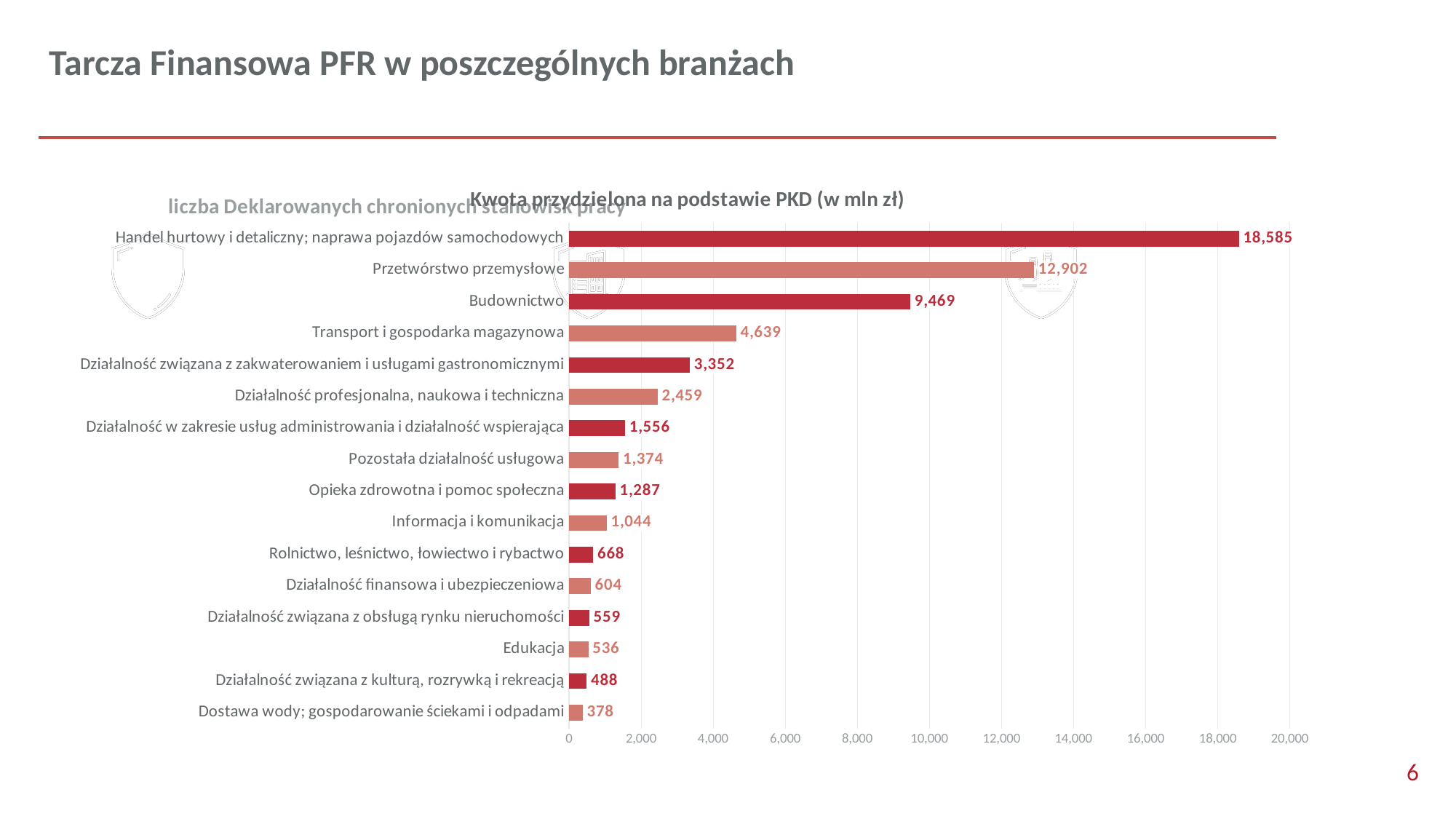
What is the value for Budownictwo? 9,469 What is the title of the chart? Kwota przydzielona na podstawie PKD (w mln zł) What is the value for Informacja i komunikacja? 1,044 What is the value for Edukacja? 536 Is the value for Przetwórstwo przemysłowe greater or less than 12,000? greater Which is larger: the value for Rolnictwo, leśnictwo, łowiectwo i rybactwo or the value for Działalność finansowa i ubezpieczeniowa? Rolnictwo, leśnictwo, łowiectwo i rybactwo Which category has the lowest value? Dostawa wody; gospodarowanie ściekami i odpadami What kind of chart is shown on the slide? bar chart Which category has the highest value? Handel hurtowy i detaliczny; naprawa pojazdów samochodowych How many categories are shown in the chart? 16 What is the value for Transport i gospodarka magazynowa? 4,639 What is the difference between the values for Handel hurtowy i detaliczny; naprawa pojazdów samochodowych and Przetwórstwo przemysłowe? 5,683